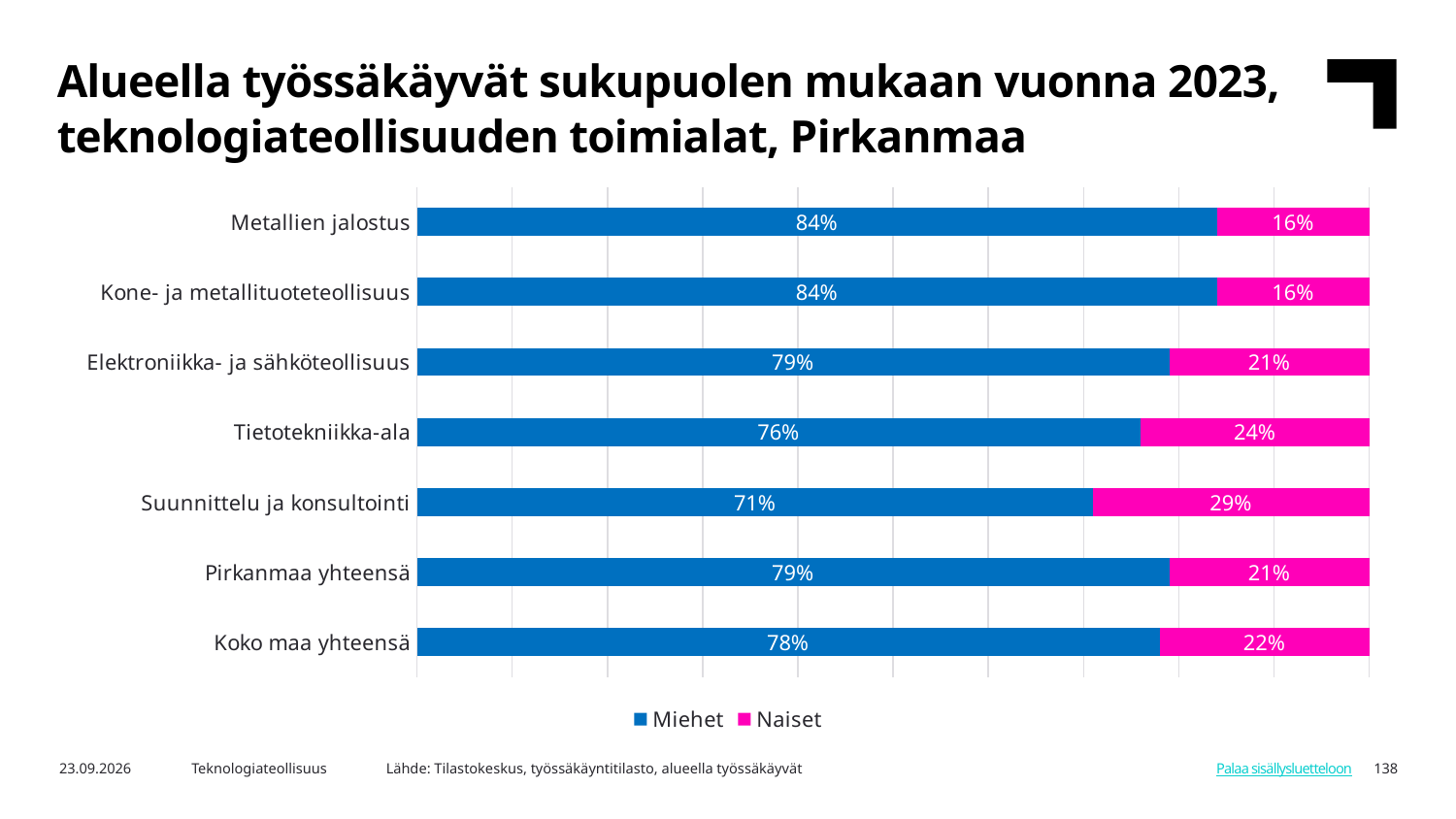
Which category has the lowest Miehet share? Suunnittelu ja konsultointi What is the Naiset share for Koko maa yhteensä? 22% Which is larger: the Miehet share for Tietotekniikka-ala or for Elektroniikka- ja sähköteollisuus? Elektroniikka- ja sähköteollisuus What is the Miehet share for Suunnittelu ja konsultointi? 71% How many series does the legend list? 2 Which category has the highest Naiset share? Suunnittelu ja konsultointi What is the Miehet share for Pirkanmaa yhteensä? 79% How many categories are shown on the chart? 7 What is the Naiset share for Tietotekniikka-ala? 24% What kind of chart is shown on the slide? Stacked bar chart What is the total of the stacked bar for Kone- ja metallituoteteollisuus? 100% What is the difference in percentage points between the Naiset share for Suunnittelu ja konsultointi and for Metallien jalostus? 13